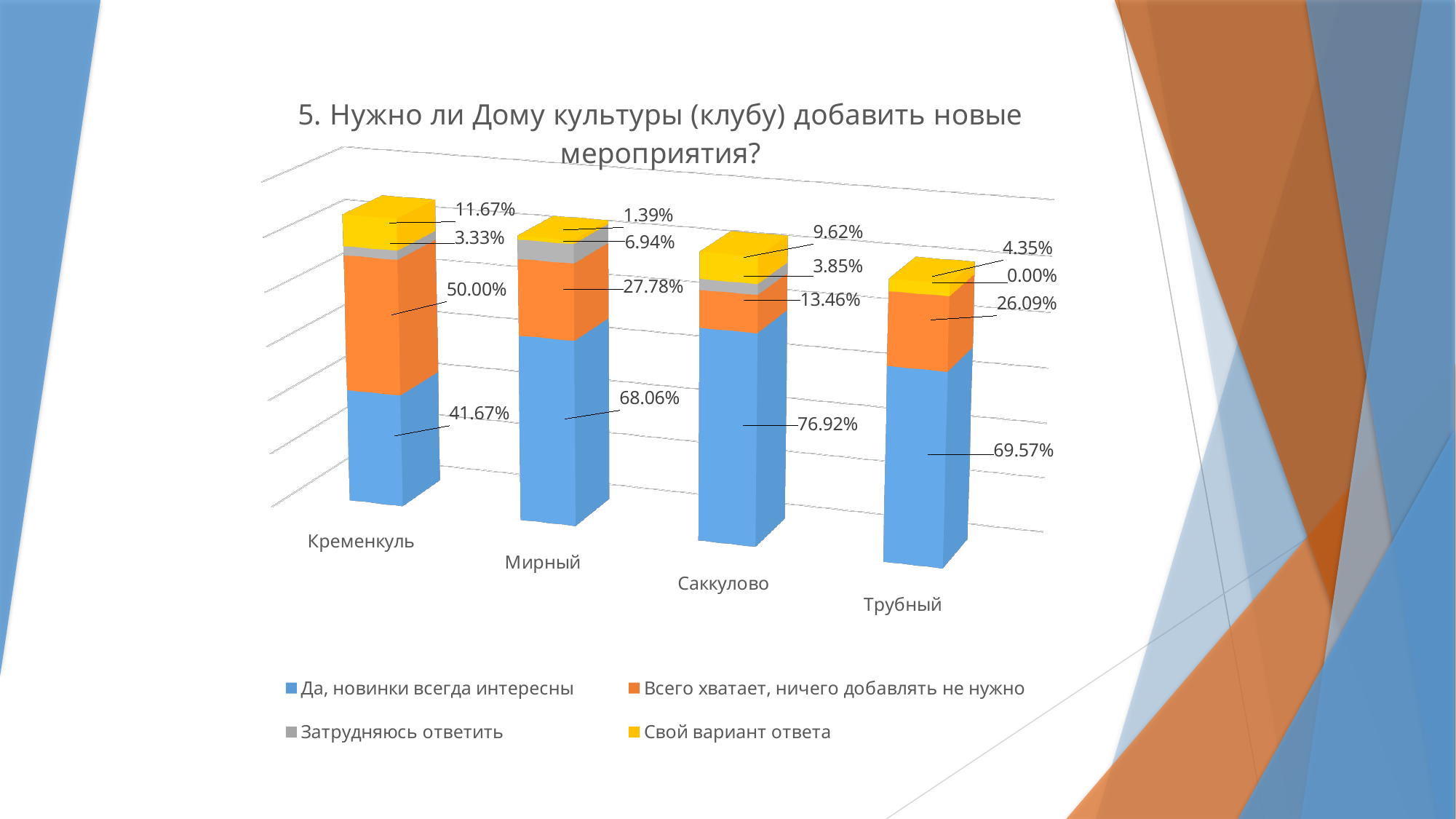
How many series does the legend list? 4 What is the value for "Свой вариант ответа" in Кременкуль? 11.67% How many categories (settlements) are shown on the x axis? 4 What is the value for "Всего хватает, ничего добавлять не нужно" in Кременкуль? 50.00% Which settlement has the lowest share for "Да, новинки всегда интересны"? Кременкуль What is the title of the chart? 5. Нужно ли Дому культуры (клубу) добавить новые мероприятия? Which settlement has the highest share for "Да, новинки всегда интересны"? Саккулово What is the value for "Да, новинки всегда интересны" in Саккулово? 76.92% What is the value for "Затрудняюсь ответить" in Трубный? 0.00% What kind of chart is shown on the slide? Stacked bar chart Which is larger: the "Да, новинки всегда интересны" value for Мирный or for Трубный? Трубный In Кременкуль, what is the difference between the "Всего хватает, ничего добавлять не нужно" value and the "Да, новинки всегда интересны" value? 8.33%